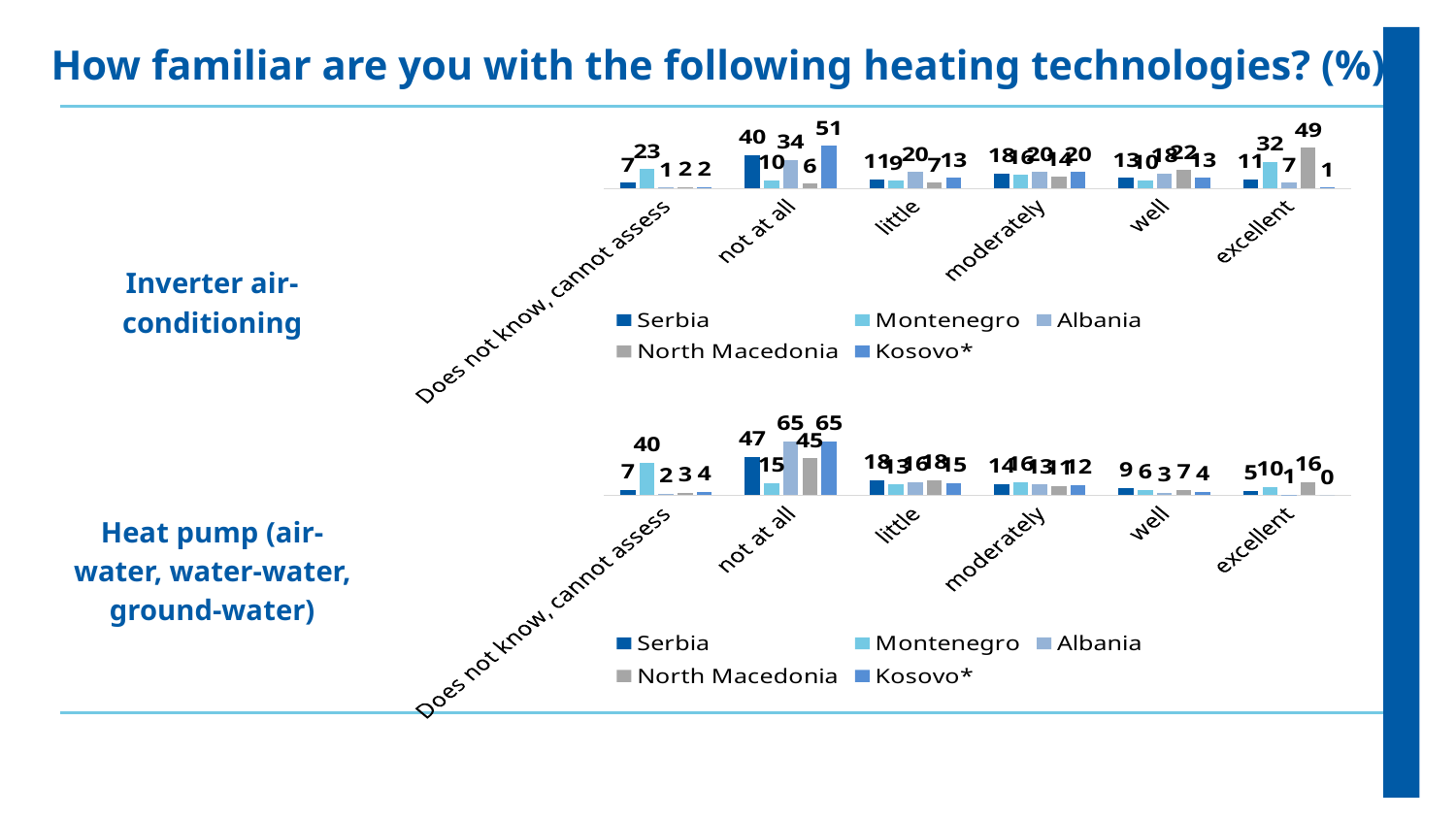
In the Heat pump chart, what is the difference between North Macedonia and Serbia in the 'excellent' category? 11 In the Inverter air-conditioning chart, which country has the highest value in the 'not at all' category? Kosovo* In the Inverter air-conditioning chart, what is the value for Kosovo* in the 'not at all' category? 51 In the Heat pump chart, what is the value for Serbia in the 'not at all' category? 47 In the Heat pump chart, what is the value for Montenegro in the 'Does not know, cannot assess' category? 40 In the Inverter air-conditioning chart, which is larger in the 'excellent' category: Montenegro or Albania? Montenegro In the Inverter air-conditioning chart, what is the difference between Serbia and Montenegro in the 'not at all' category? 30 In the Inverter air-conditioning chart, what is the value for Montenegro in the 'Does not know, cannot assess' category? 23 In the Heat pump chart, which country has the lowest value in the 'excellent' category? Kosovo* How many categories are shown on the x axis of the Inverter air-conditioning chart? 6 In the Inverter air-conditioning chart, what is the value for North Macedonia in the 'excellent' category? 49 How many series does the legend of the Heat pump chart list? 5